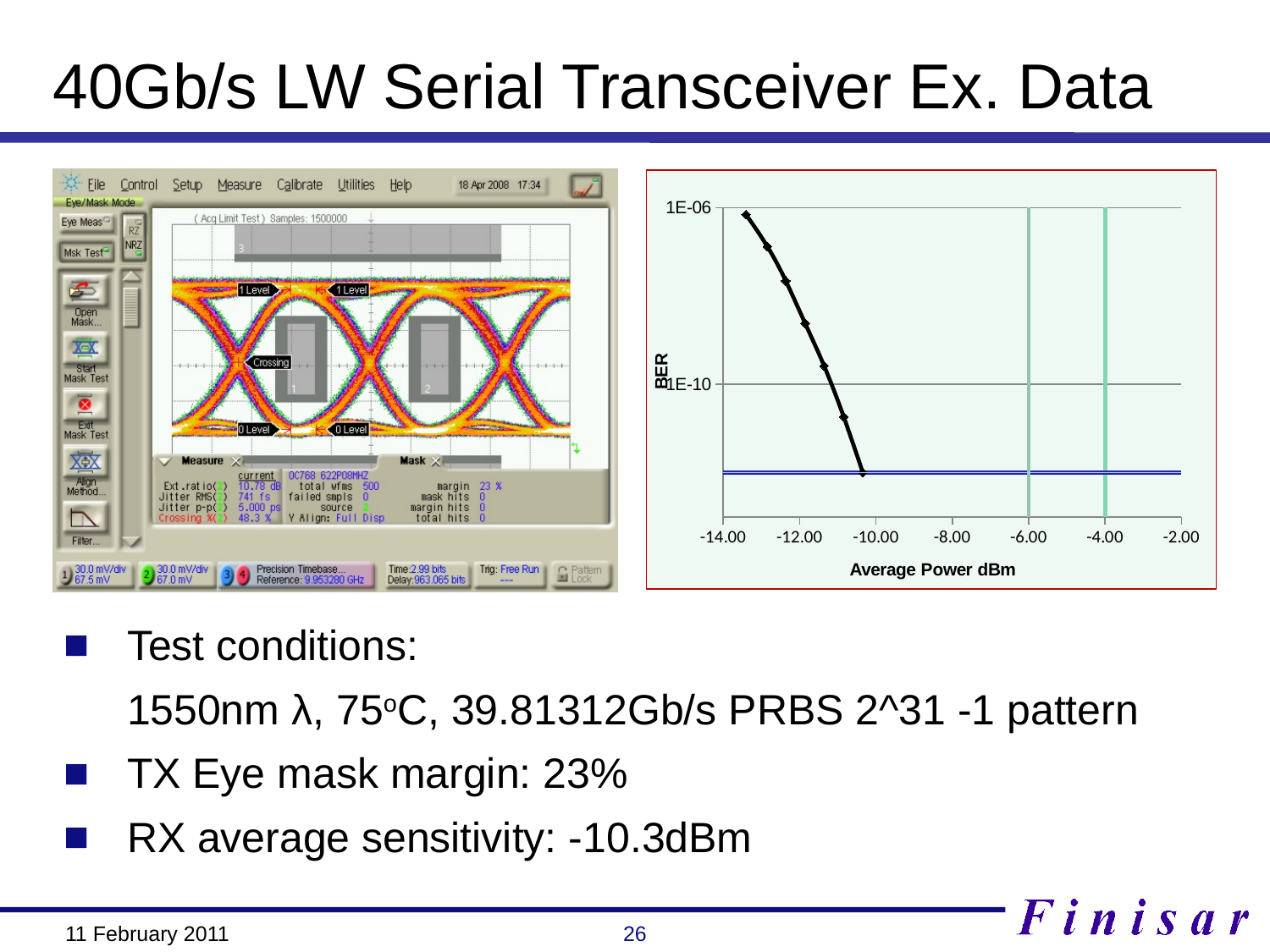
In the BER chart, does the BER rise or fall as average power increases along the x axis? fall In the BER chart, how many tick labels are shown on the x axis? 7 In the BER chart, what is the title of the y axis? BER In the BER chart, what is the highest BER value labelled on the y axis? 1E-06 In the BER chart, is the BER at -12.00 dBm greater or less than 1E-10? greater In the BER chart, what is the title of the x axis? Average Power dBm What kind of chart is shown on the right side of the slide? line chart In the BER chart, what is the leftmost value labelled on the x axis? -14.00 In the BER chart, what is the rightmost value labelled on the x axis? -2.00 In the BER chart, what is the lowest BER value labelled on the y axis? 1E-10 In the BER chart, is the BER at the right-hand end of the curve (around -10.3 dBm) greater or less than 1E-10? less In the BER chart, is the BER at the leftmost data point greater or less than 1E-10? greater